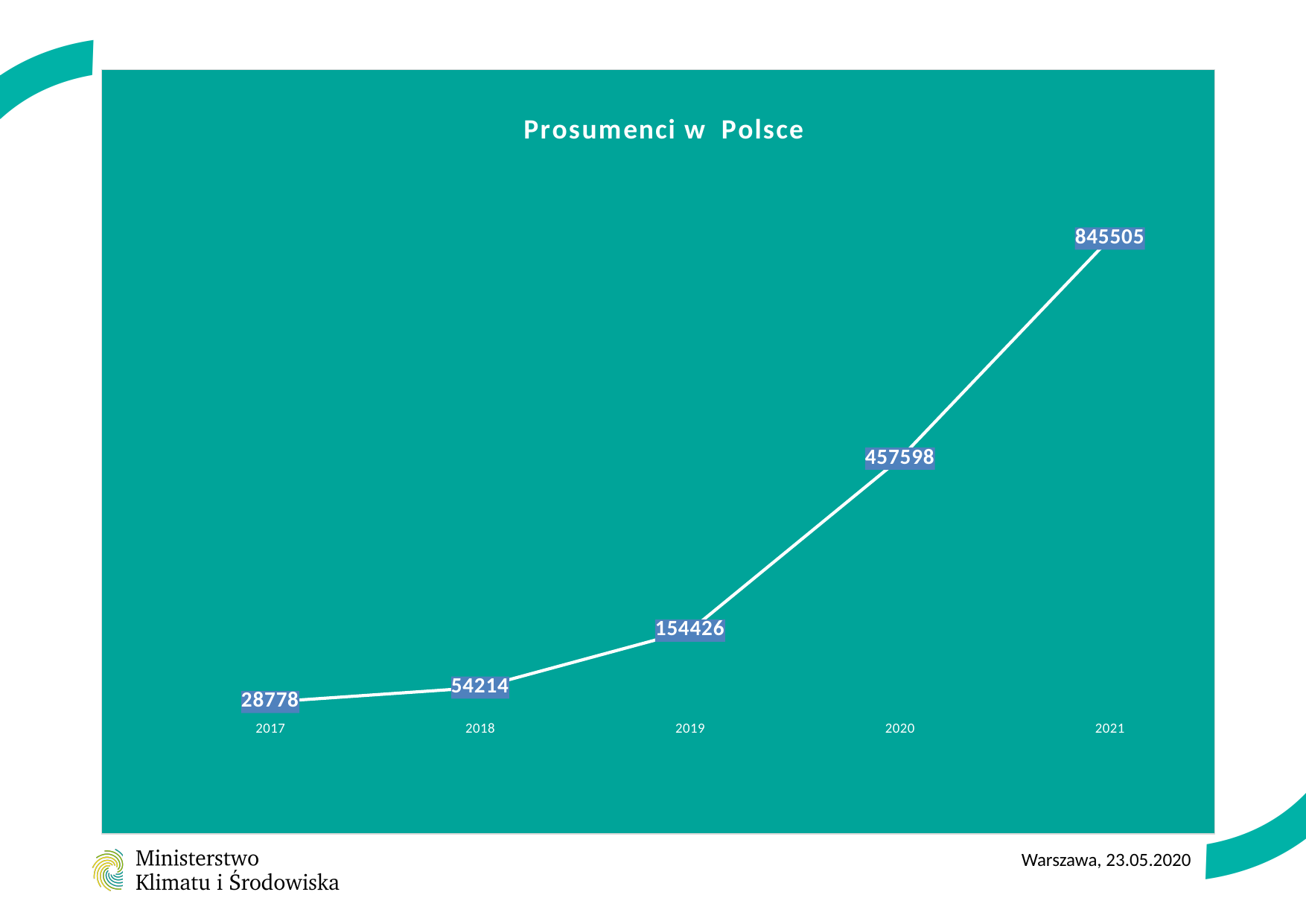
What is the value for 2021? 845505 What is the value for 2020? 457598 Which year has the lowest value? 2017 What is the value for 2017? 28778 What is the difference between the values for 2018 and 2017? 25436 Do the values rise or fall from 2017 to 2021? rise Which is larger, the value for 2019 or the value for 2018? 2019 What is the difference between the values for 2021 and 2020? 387907 How many data points are plotted on the chart? 5 Which year has the highest value? 2021 What is the value for 2019? 154426 What kind of chart is shown? line chart